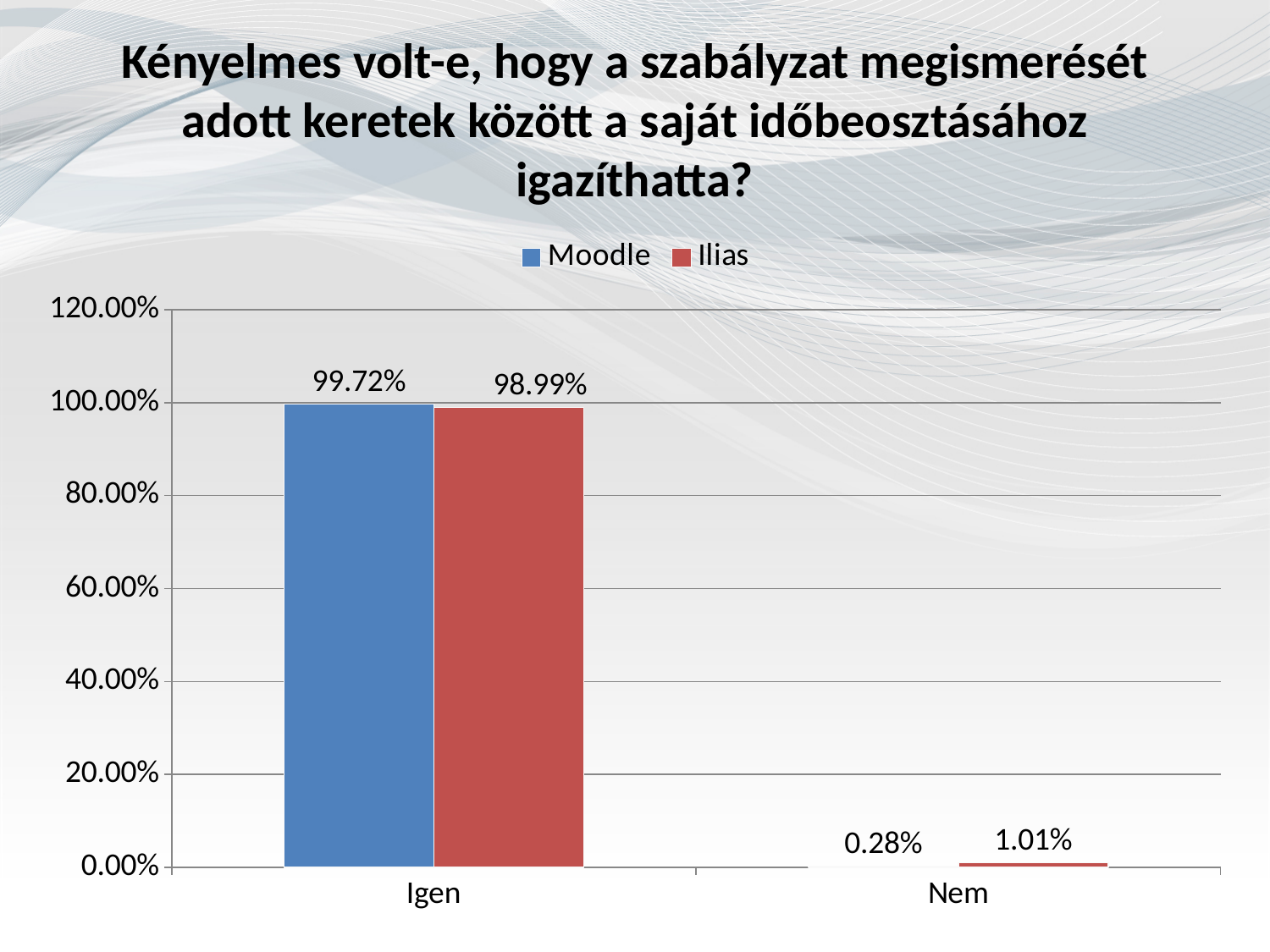
What is the value for Ilias in the Nem category? 1.01% Which series has the higher value in the Nem category, Moodle or Ilias? Ilias What is the difference between the Moodle and Ilias values in the Igen category? 0.73% What is the value for Ilias in the Igen category? 98.99% How many categories are shown on the x axis? 2 What is the difference between the Ilias and Moodle values in the Nem category? 0.73% What is the value for Moodle in the Nem category? 0.28% Which series has the higher value in the Igen category, Moodle or Ilias? Moodle Which colour represents the Ilias series in the legend? Red What is the value for Moodle in the Igen category? 99.72% What kind of chart is shown on the slide? Bar chart How many series does the legend list? 2